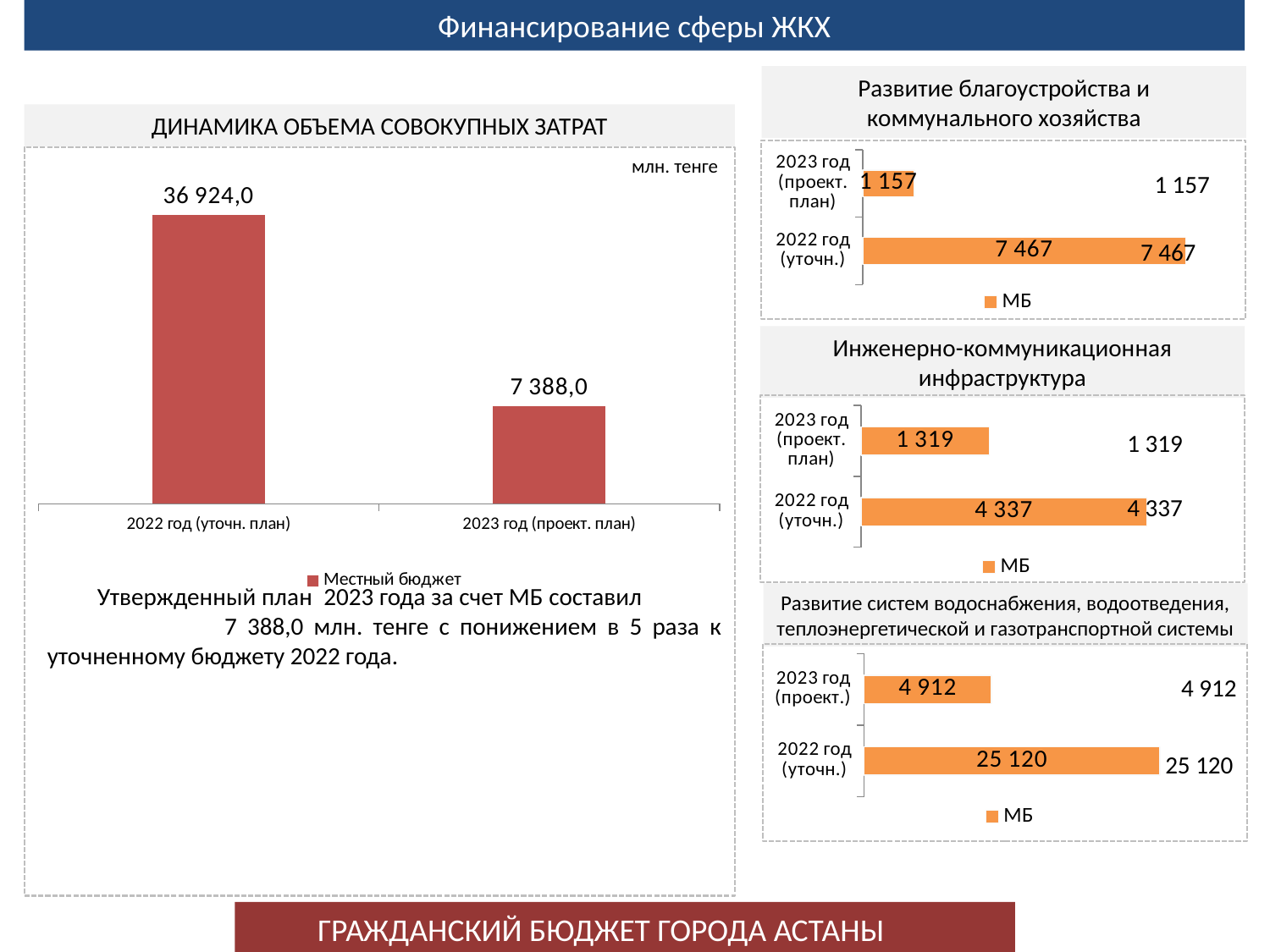
In the chart 'Развитие благоустройства и коммунального хозяйства', which year has the higher value? 2022 год (уточн.) In the chart 'ДИНАМИКА ОБЪЕМА СОВОКУПНЫХ ЗАТРАТ', what kind of chart is shown? bar chart In the chart 'Инженерно-коммуникационная инфраструктура', what is the value for 2022 год (уточн.)? 4 337 In the chart 'Развитие благоустройства и коммунального хозяйства', what is the value for 2023 год (проект. план)? 1 157 In the chart 'Развитие систем водоснабжения, водоотведения, теплоэнергетической и газотранспортной системы', what is the value for 2022 год (уточн.)? 25 120 In the chart 'ДИНАМИКА ОБЪЕМА СОВОКУПНЫХ ЗАТРАТ', what is the difference between the 2022 and 2023 values? 29 536,0 In the chart 'ДИНАМИКА ОБЪЕМА СОВОКУПНЫХ ЗАТРАТ', what series name does the legend show? Местный бюджет In the chart 'ДИНАМИКА ОБЪЕМА СОВОКУПНЫХ ЗАТРАТ', what is the value for 2023 год (проект. план)? 7 388,0 In the chart 'ДИНАМИКА ОБЪЕМА СОВОКУПНЫХ ЗАТРАТ', what is the value for 2022 год (уточн. план)? 36 924,0 In the chart 'Развитие благоустройства и коммунального хозяйства', what is the value for 2022 год (уточн.)? 7 467 In the chart 'Инженерно-коммуникационная инфраструктура', what is the difference between the 2022 and 2023 values? 3 018 In the chart 'Развитие систем водоснабжения, водоотведения, теплоэнергетической и газотранспортной системы', which year has the lower value? 2023 год (проект.)